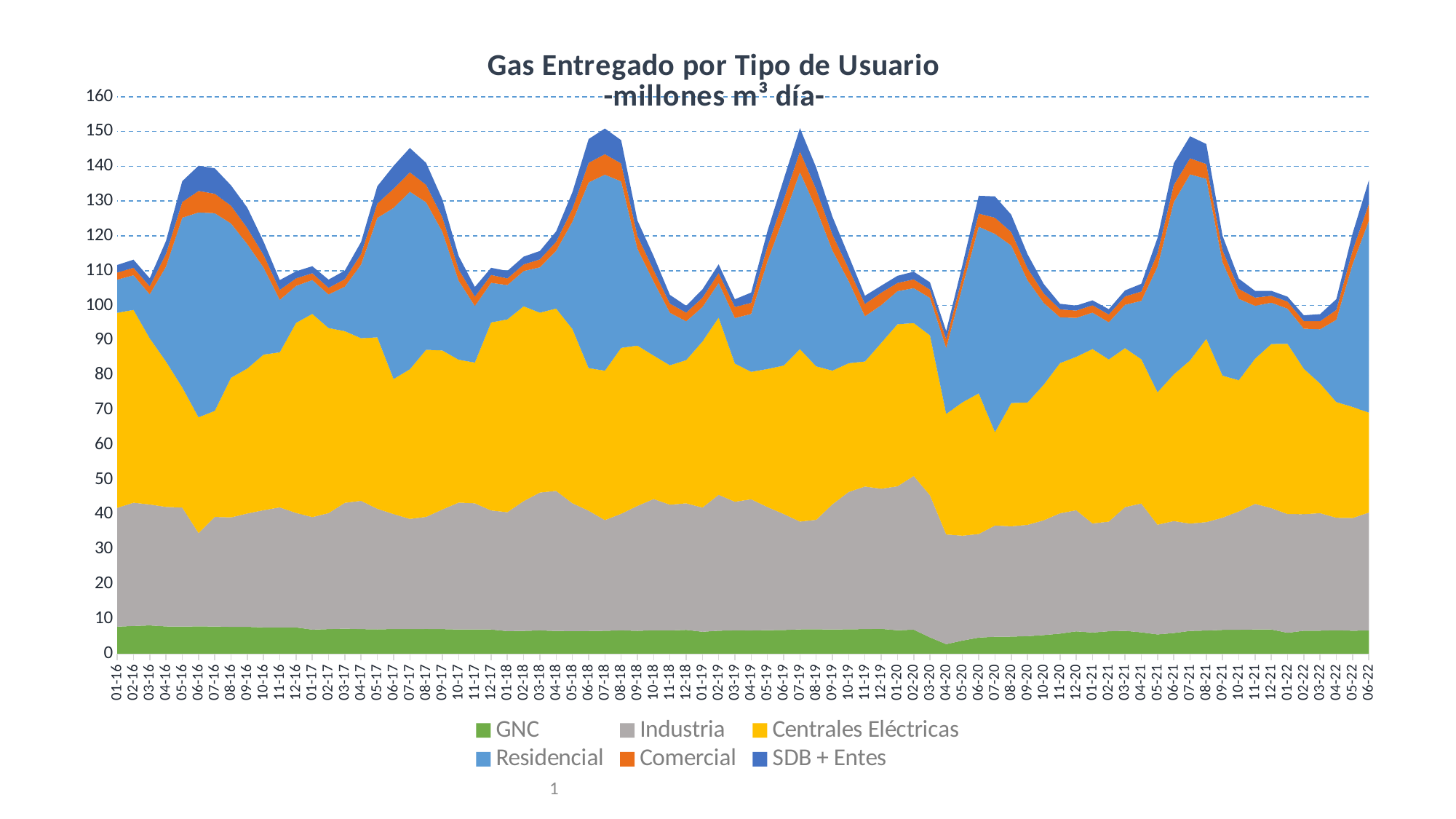
How many series does the legend list? 6 Is the total value for 07-18 greater or less than 140? greater How many monthly points are plotted along the x axis (from 01-16 to 06-22)? 78 What kind of chart is shown on the slide? Stacked area chart Is the total value for 04-20 greater or less than 100? less What is the title of the chart? Gas Entregado por Tipo de Usuario -millones m³ día- Is the total value for 07-21 greater or less than 140? greater Which has the larger total value, 07-18 or 07-20? 07-18 Which month has the lowest total value? 04-20 Which series is plotted at the bottom of the stack? GNC